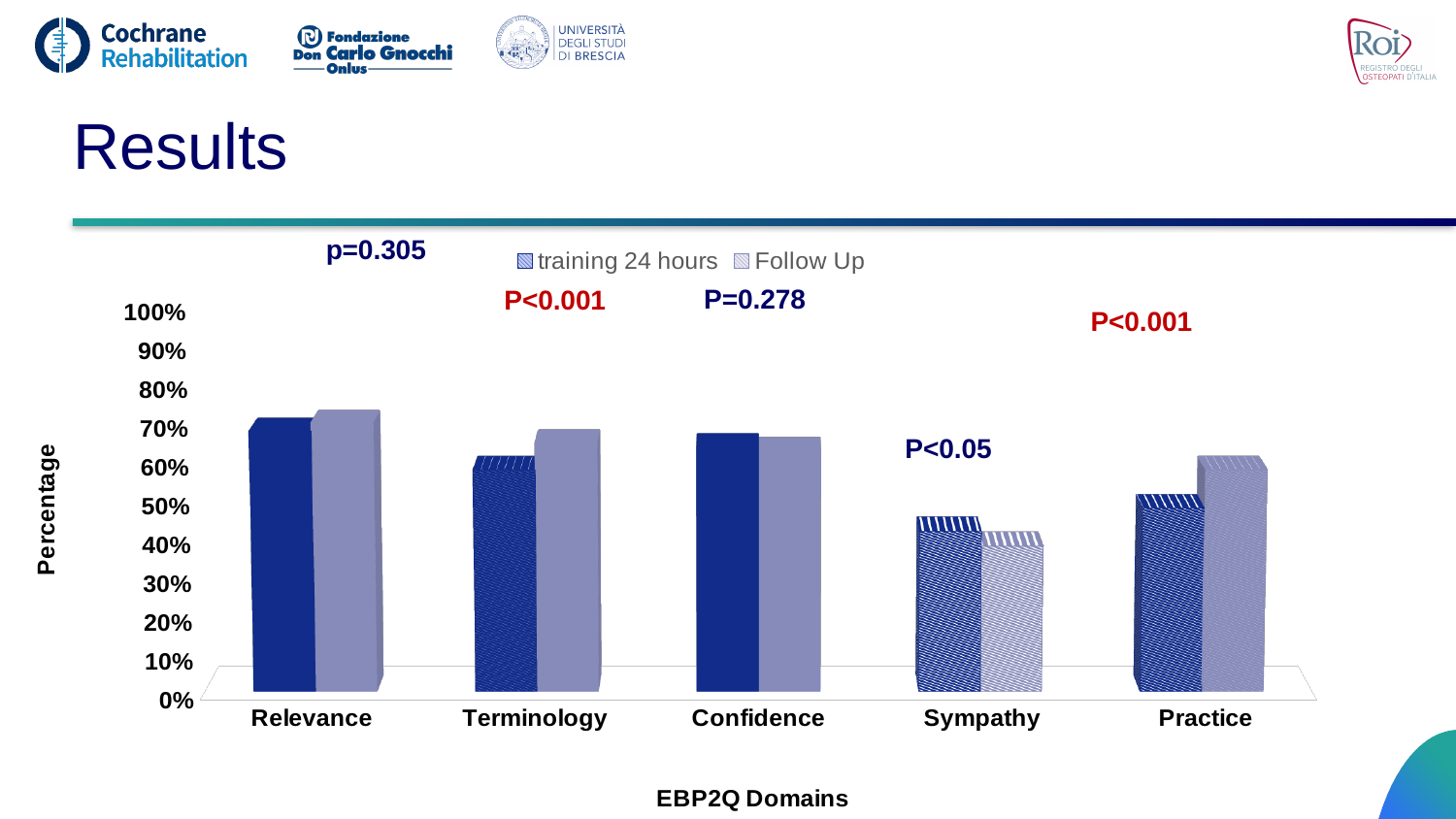
What are the two series named in the legend? training 24 hours and Follow Up Which domain has the lowest value for the training 24 hours series? Sympathy Which domain has the highest value for the Follow Up series? Relevance For Practice, which is larger: training 24 hours or Follow Up? Follow Up Is the Follow Up value for Practice greater or less than 50%? greater For Terminology, which is larger: training 24 hours or Follow Up? Follow Up How many EBP2Q domains (categories) are shown on the x axis? 5 What is the title of the x axis? EBP2Q Domains What kind of chart is shown on the slide? Bar chart Is the training 24 hours value for Sympathy greater or less than 60%? less Which domain has the lowest value for the Follow Up series? Sympathy How many series does the legend list? 2